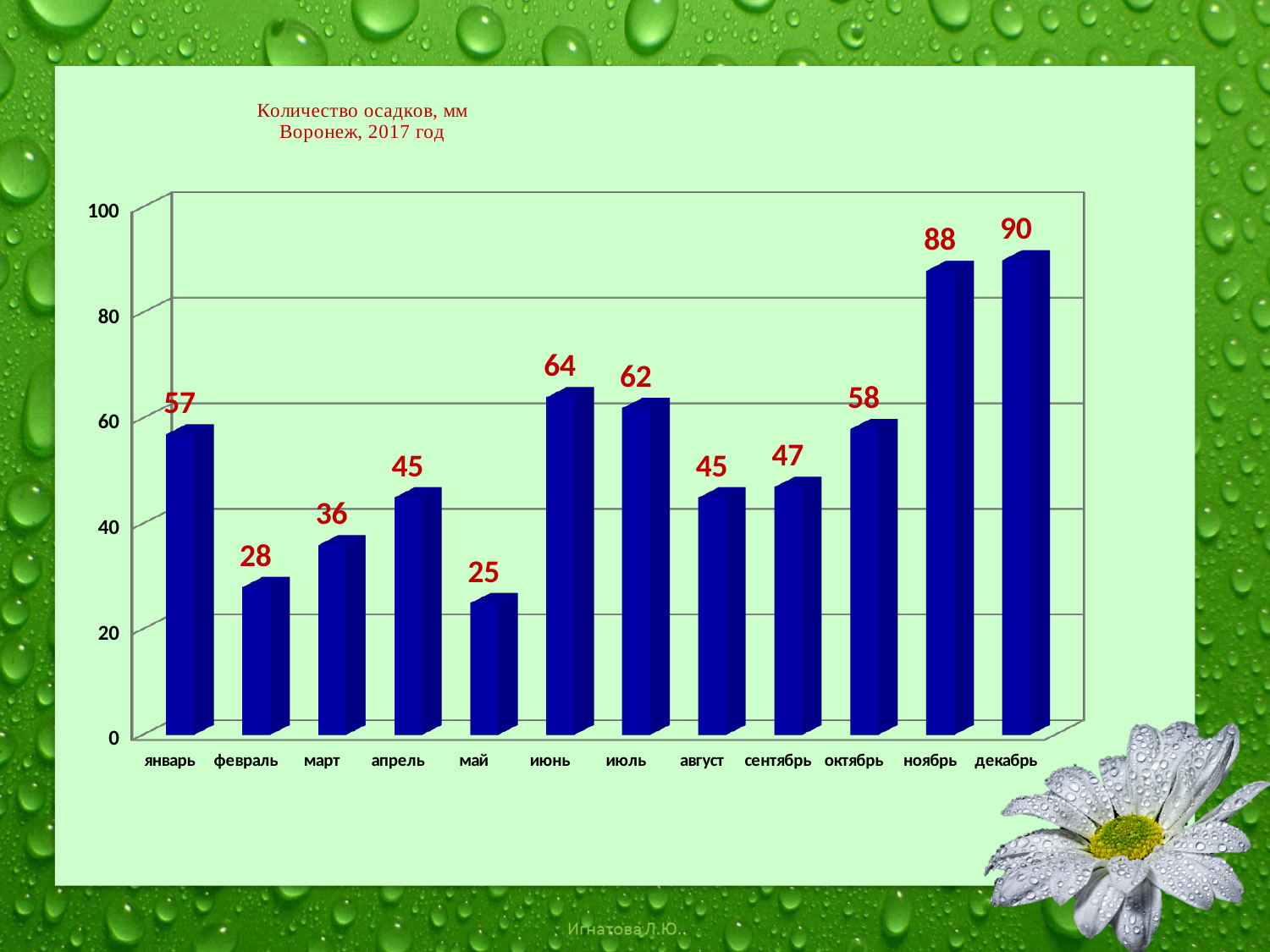
What is the difference between the precipitation in ноябрь and октябрь? 30 How many months (categories) are shown on the chart? 12 What kind of chart is shown on the slide? bar chart Which month has more precipitation, июль or август? июль Is the value for сентябрь greater or less than 40? greater Do the values rise or fall from октябрь to декабрь? rise What is the precipitation value for июнь (June)? 64 Which month has the lowest precipitation? май What is the title of the chart? Количество осадков, мм Воронеж, 2017 год What is the difference between the precipitation in декабрь and май? 65 What is the precipitation value for февраль (February)? 28 Which month has the highest precipitation? декабрь